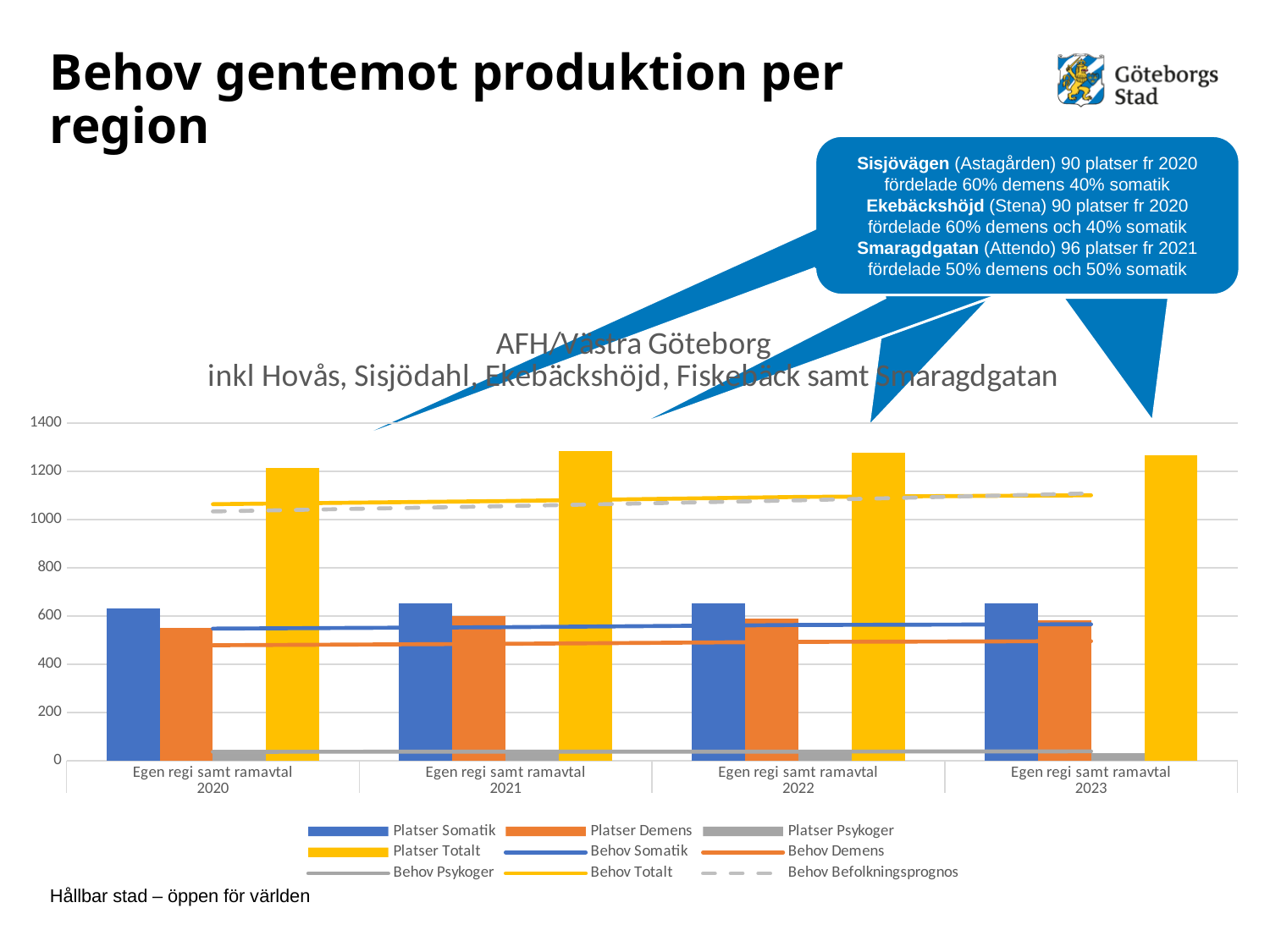
Does the Behov Totalt line rise or fall from 2020 to 2023? rises What is the title of the chart? AFH/Västra Göteborg inkl Hovås, Sisjödahl, Ekebäckshöjd, Fiskebäck samt Smaragdgatan Which series is drawn as a dashed grey line in the chart? Behov Befolkningsprognos Is the value of Platser Psykoger for 2022 greater or less than 200? less Is the value of Platser Somatik for 2020 greater or less than 600? greater In 2020, which is larger: Platser Somatik or Platser Demens? Platser Somatik What kind of chart is shown on the slide? A combined bar and line chart How many year categories are shown on the x axis of the chart? 4 How many series does the chart legend list? 9 In which year is the Platser Totalt bar the lowest? 2020 Is the value of Platser Demens for 2020 greater or less than 600? less